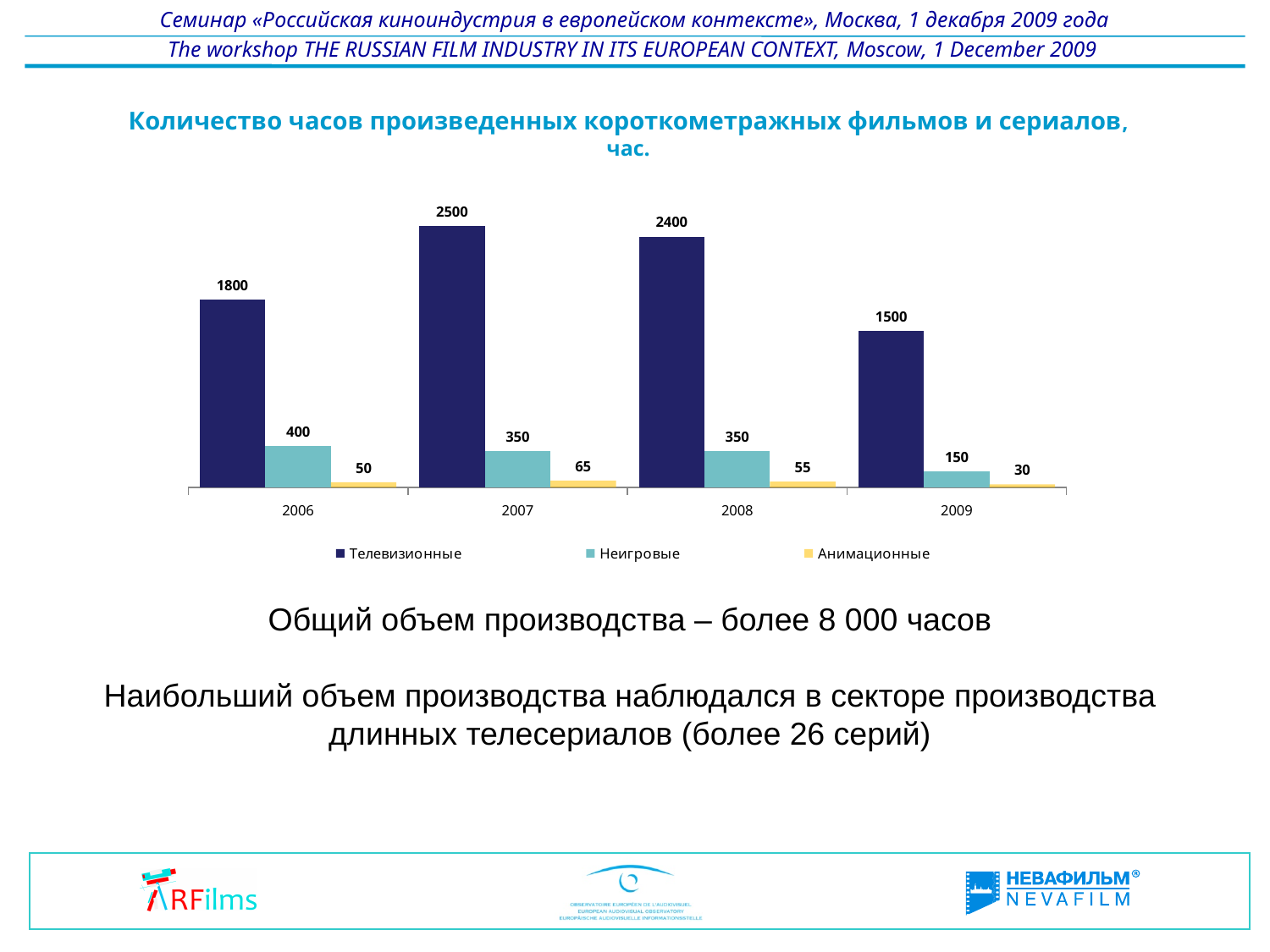
In which year is the Неигровые value lowest? 2009 What kind of chart is shown on the slide? bar chart What is the value for Телевизионные in 2007? 2500 What is the value for Анимационные in 2009? 30 What is the difference between the Телевизионные values for 2007 and 2009? 1000 Does the Неигровые value rise or fall from 2008 to 2009? fall In which year is the Телевизионные value highest? 2007 Which is larger: the Анимационные value for 2007 or for 2008? 2007 How many years are shown on the x axis? 4 How many series does the legend list? 3 Which series is shown in dark blue in the legend? Телевизионные What is the value for Неигровые in 2006? 400